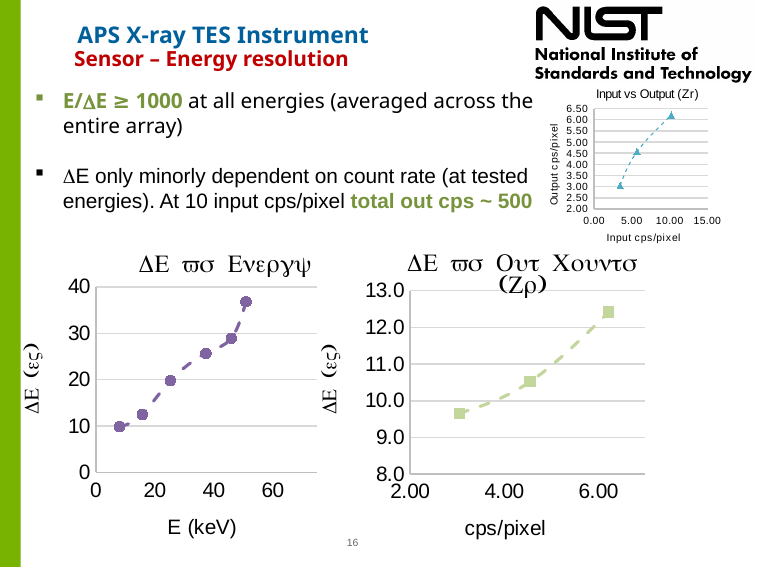
In the bottom-left chart (ΔE vs Energy), how many data points are plotted? 6 What is the x-axis label of the bottom-left chart (ΔE vs Energy)? E (keV) In the bottom-right chart (ΔE vs Out Counts), is the ΔE value of the rightmost point greater or less than 12.0? greater In the bottom-right chart (ΔE vs Out Counts), how many data points are plotted? 3 In the bottom-left chart (ΔE vs Energy), does ΔE rise or fall as E increases? rise In the bottom-left chart (ΔE vs Energy), is the ΔE value of the rightmost point (near 50 keV) greater or less than 30? greater In the top-right chart titled 'Input vs Output (Zr)', is the output value at 10 input cps/pixel greater or less than 5.00? greater What type of chart is the bottom-left chart (ΔE vs Energy)? scatter chart What is the x-axis label of the bottom-right chart (ΔE vs Out Counts)? cps/pixel In the top-right chart titled 'Input vs Output (Zr)', how many data points are plotted? 3